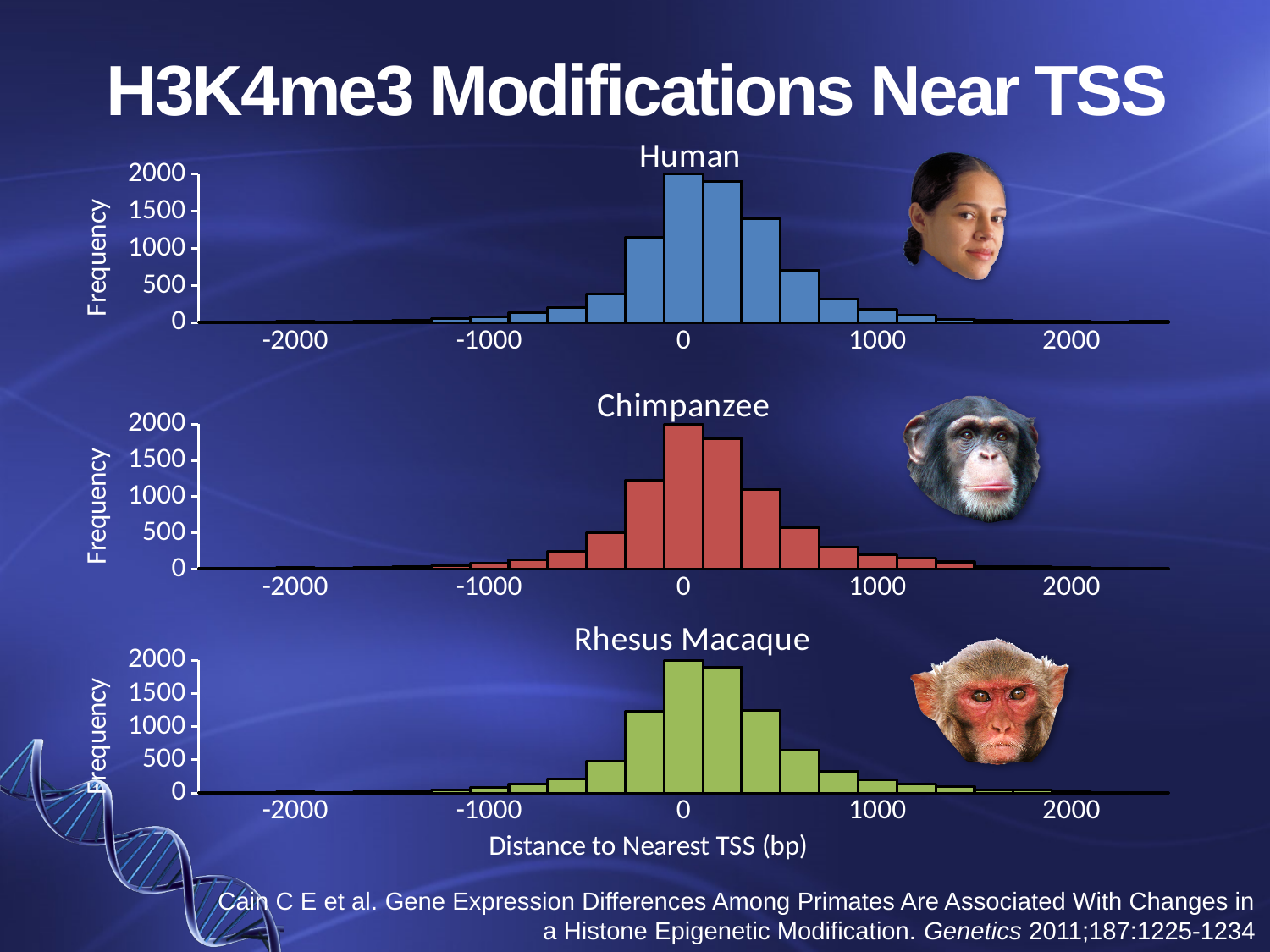
In the Human chart, is the value of the tallest bar (just right of 0 on the x axis) greater or less than 1500? greater In the Chimpanzee chart, is the value of the bar between 750 and 1000 on the x axis greater or less than 500? less In the Chimpanzee chart, is the bar just right of 0 on the x axis taller or shorter than the bar between 1000 and 1250? taller What is the title of the bottom chart? Rhesus Macaque How many charts are shown on the slide? 3 What colour are the bars in the Chimpanzee chart? red In the Rhesus Macaque chart, is the value of the bar just right of 0 on the x axis greater or less than 1500? greater What is the maximum value shown on the y axis of each chart? 2000 Around which x-axis value do the bars in the Human chart reach their peak? 0 What kind of chart is used for the Human panel? bar chart (histogram) In the Rhesus Macaque chart, do the bar heights rise or fall as the x axis moves from 500 toward 2000? fall